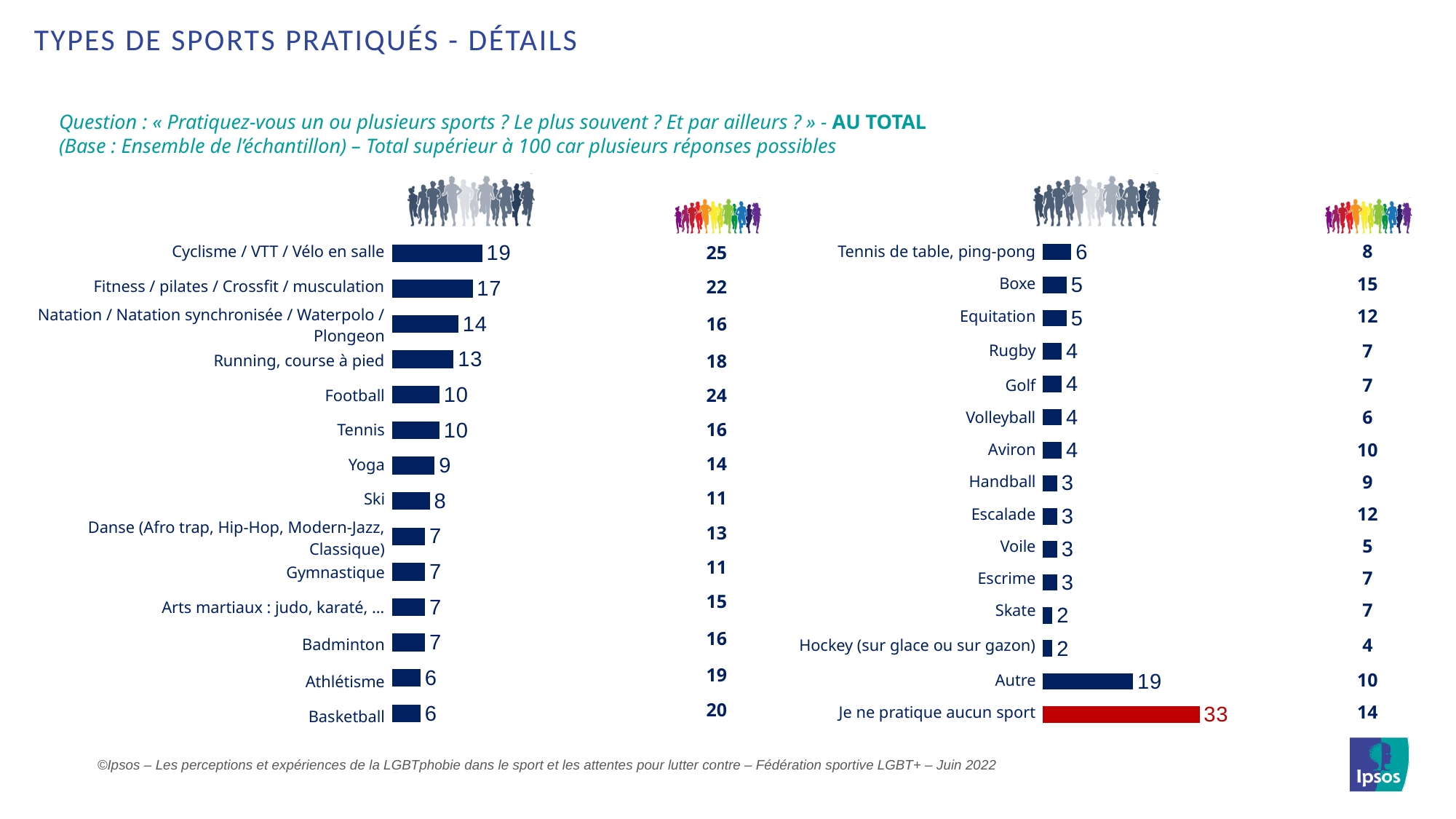
On the right chart, which category has the highest value? Je ne pratique aucun sport On the right chart, what is the difference between the values for Je ne pratique aucun sport and Autre? 14 How many categories are shown on the right chart? 15 On the left chart, which is larger, the value for Yoga or the value for Ski? Yoga On the left chart, what is the value for Running, course à pied? 13 On the left chart, what is the difference between the values for Cyclisme / VTT / Vélo en salle and Fitness / pilates / Crossfit / musculation? 2 On the left chart, which category has the highest value? Cyclisme / VTT / Vélo en salle How many categories are shown on the left chart? 14 What type of chart is used on the left side of the slide? Bar chart On the right chart, what is the value for Je ne pratique aucun sport? 33 On the left chart, what is the value for Cyclisme / VTT / Vélo en salle? 19 On the right chart, what is the value for Boxe? 5